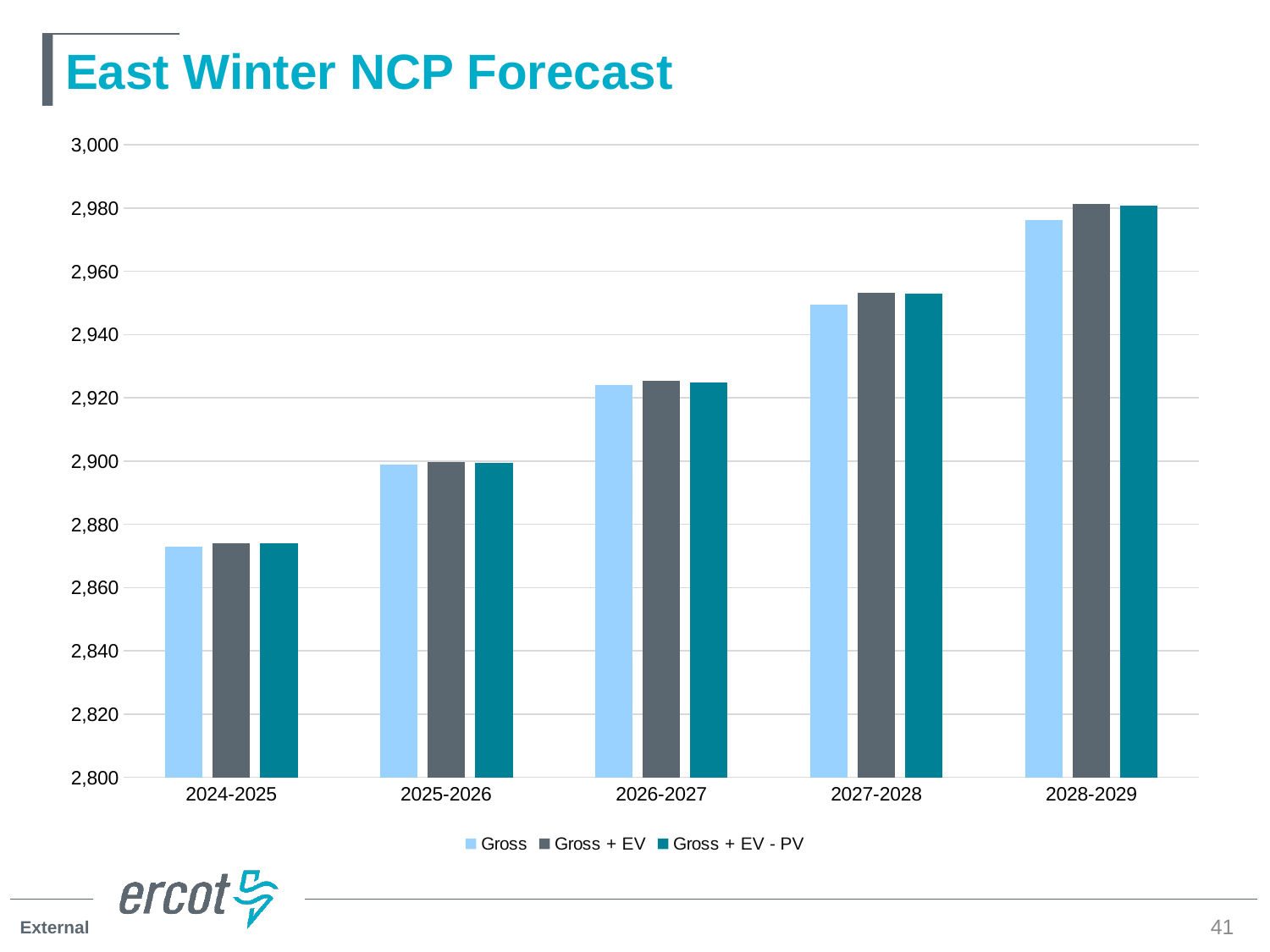
What kind of chart is shown on the slide? bar chart How many winter seasons (categories) are shown on the x axis? 5 What is the title of the chart? East Winter NCP Forecast Which is larger, the Gross value for 2027-2028 or the Gross value for 2028-2029? 2028-2029 Do the Gross values rise or fall from 2024-2025 to 2028-2029? rise Is the Gross value for 2028-2029 greater or less than 2,960? greater Is the Gross value for 2024-2025 greater or less than 2,880? less How many series does the legend list? 3 Which winter season has the highest Gross value? 2028-2029 Is the Gross + EV - PV value for 2026-2027 greater or less than 2,920? greater Which winter season has the lowest Gross + EV value? 2024-2025